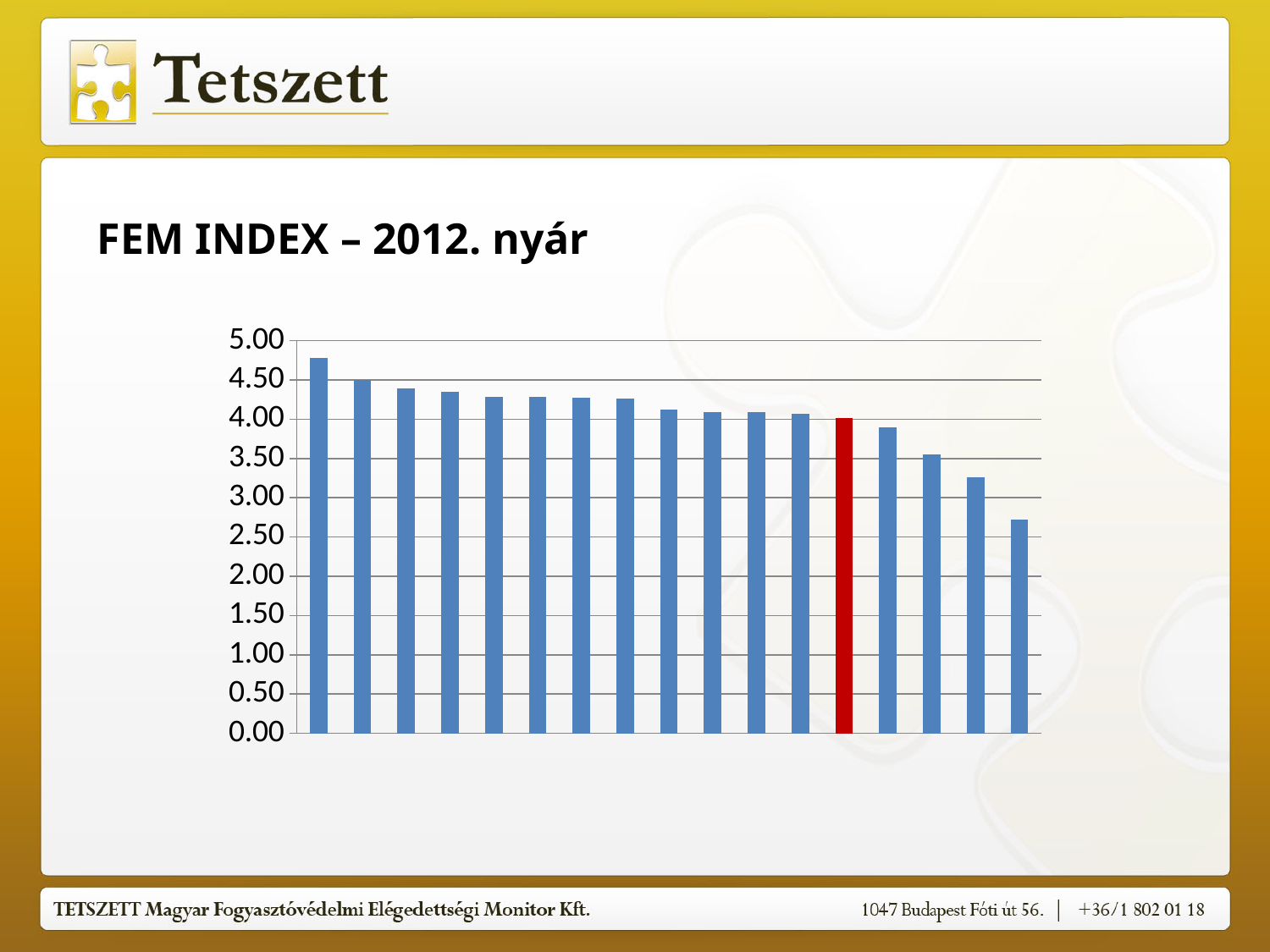
Is the value of the leftmost bar greater or less than 4.50? greater Which bar is the lowest in the chart? the last (rightmost) bar Is the value of the second bar from the right greater or less than 3.50? less What is the title of the chart on the slide? FEM INDEX – 2012. nyár How many bars are plotted in the chart? 17 Is the value of the red bar greater or less than 3.50? greater Do the bar values rise or fall from left to right across the chart? fall What is the highest value shown on the vertical axis of the chart? 5.00 What kind of chart is shown on the slide? bar chart Which is larger, the leftmost bar or the red bar? the leftmost bar Which bar is the highest in the chart? the first (leftmost) bar